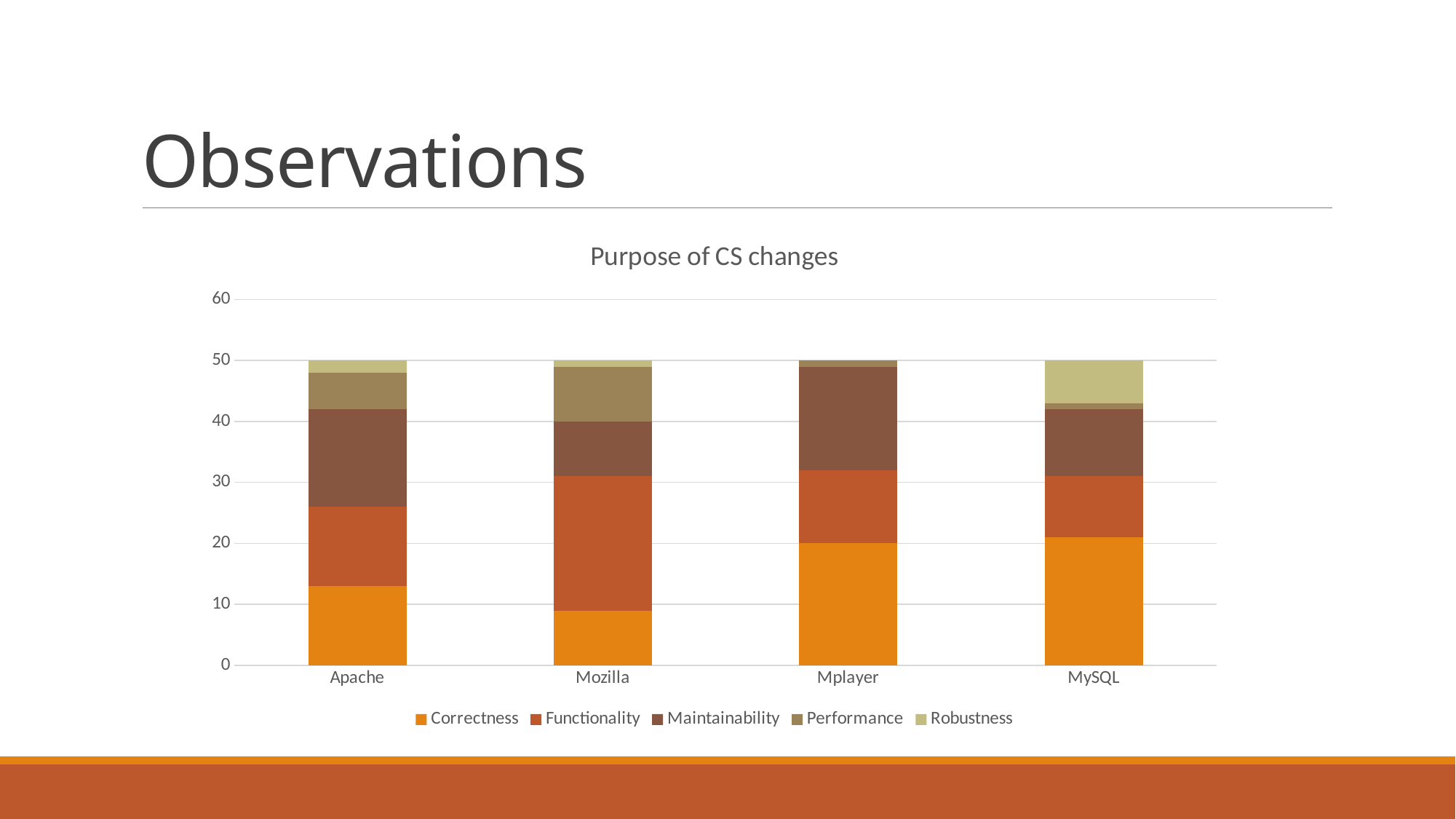
Which project has the smallest Correctness segment? Mozilla What is the Correctness value for Mplayer? 20 What is the total height of the stacked bar for Apache? 50 Is the Correctness value for Apache greater or less than 10? greater How many projects (categories) are shown on the x axis? 4 Which project has the largest Functionality segment? Mozilla How many series does the legend list? 5 Is the Robustness value for MySQL greater or less than 10? less What is the title of the chart? Purpose of CS changes What kind of chart is shown on the slide? stacked bar chart Which project has the largest Robustness segment? MySQL Which is larger, the Correctness value for Mplayer or for Mozilla? Mplayer